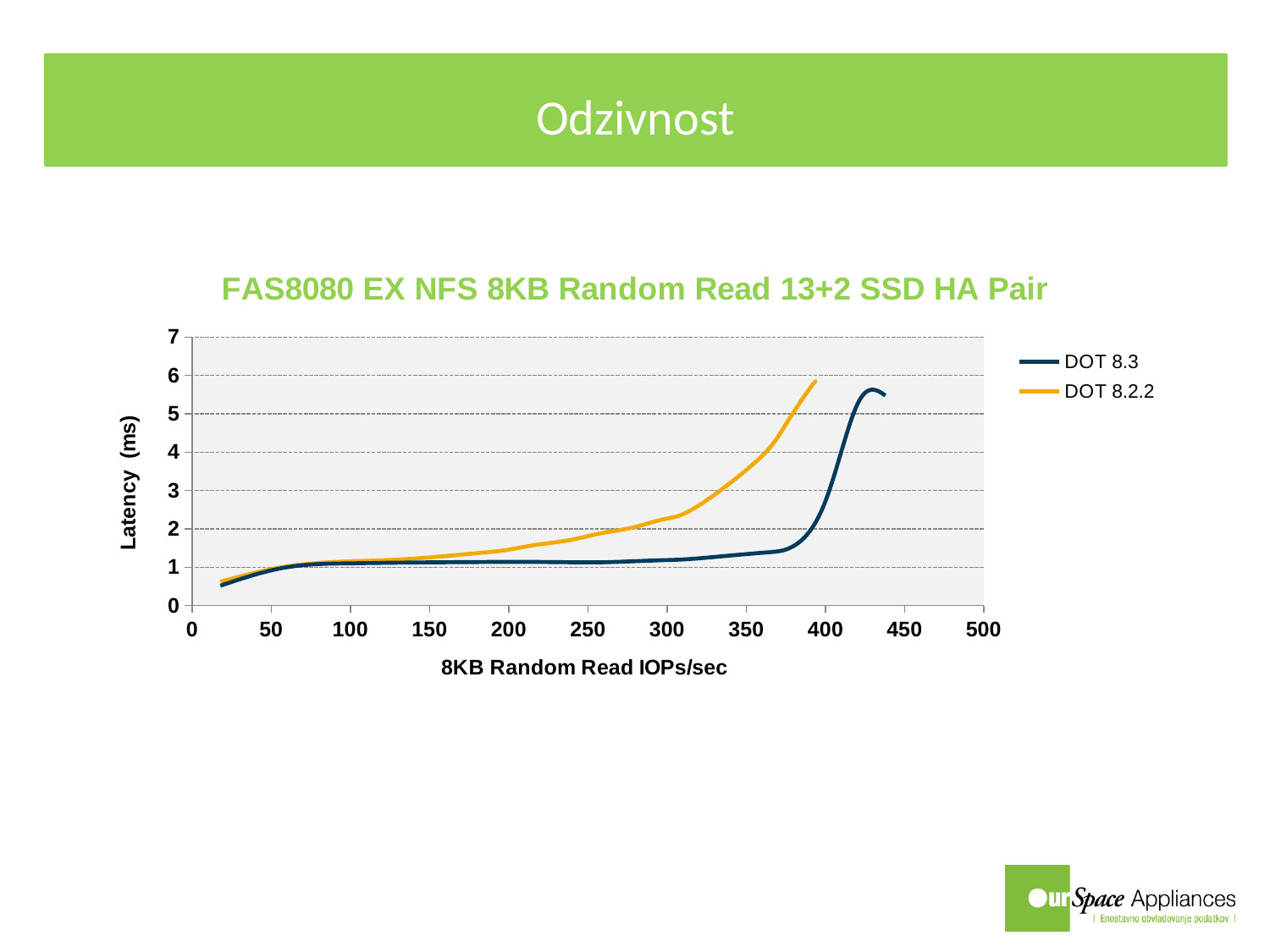
At 200 IOPs/sec, is the latency for DOT 8.2.2 greater or less than 1 ms? greater What is the title of the chart? FAS8080 EX NFS 8KB Random Read 13+2 SSD HA Pair At 300 IOPs/sec, is the latency for DOT 8.3 greater or less than 2 ms? less At 300 IOPs/sec, which series has the higher latency, DOT 8.3 or DOT 8.2.2? DOT 8.2.2 What kind of chart is shown on the slide? line chart How many series does the legend list? 2 Is the highest IOPs/sec value reached by the DOT 8.2.2 line greater or less than 400? less Which series reaches a higher IOPs/sec value before its latency spikes, DOT 8.3 or DOT 8.2.2? DOT 8.3 What is the label of the y axis? Latency (ms) Does latency rise or fall as 8KB Random Read IOPs/sec increases? rise